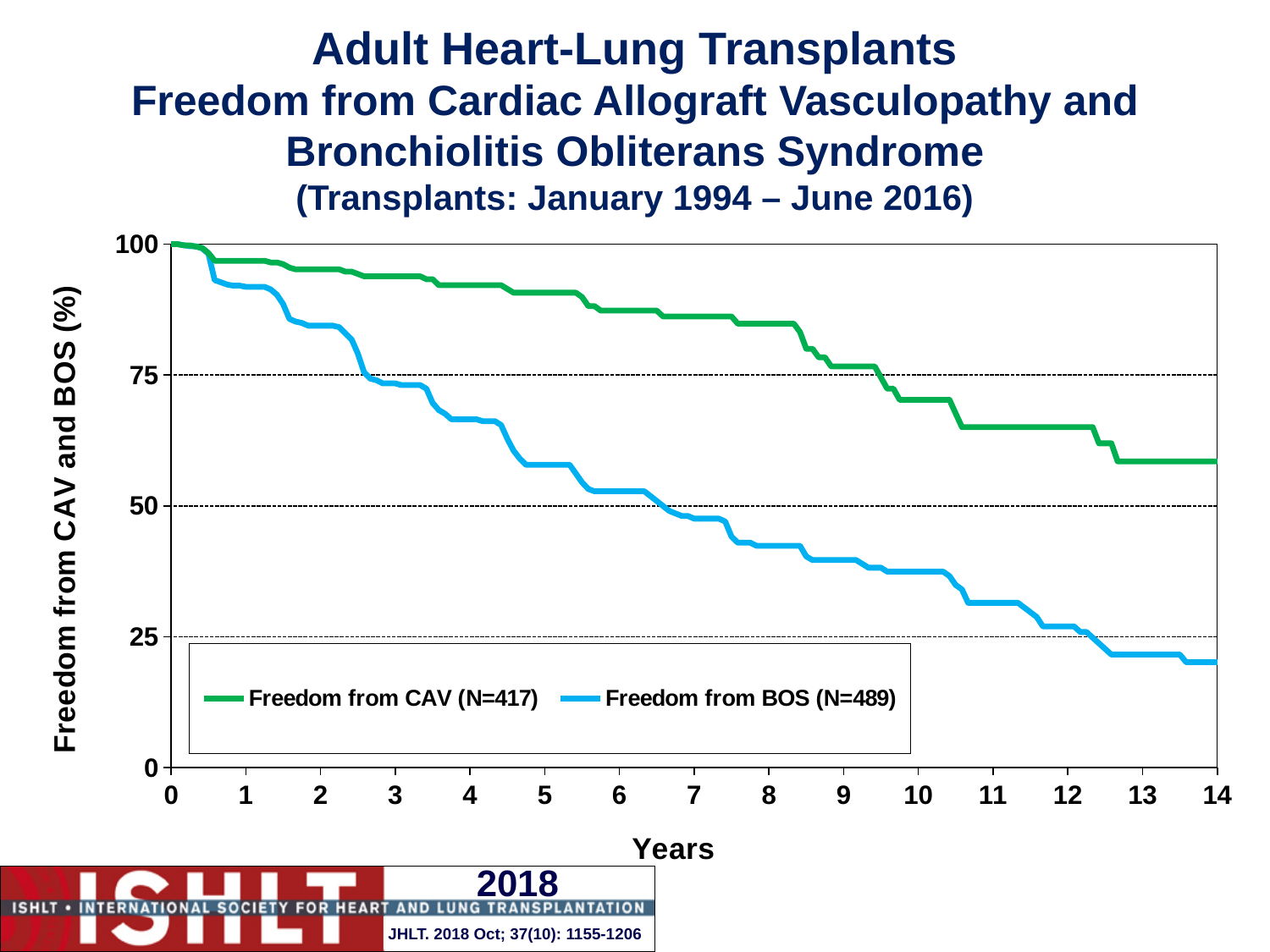
What is the N reported in the legend for Freedom from BOS? N=489 What is the value of Freedom from CAV at year 0? 100 Is the value for Freedom from BOS at year 2 greater or less than 75? greater Is the value for Freedom from CAV at year 5 greater or less than 75? greater Is the value for Freedom from CAV at year 10 greater or less than 50? greater Do the values for Freedom from BOS rise or fall as years increase? Fall What is the label of the x axis? Years What kind of chart is shown on the slide? Line chart At year 7, which series has the higher value, Freedom from CAV or Freedom from BOS? Freedom from CAV How many series does the legend list? 2